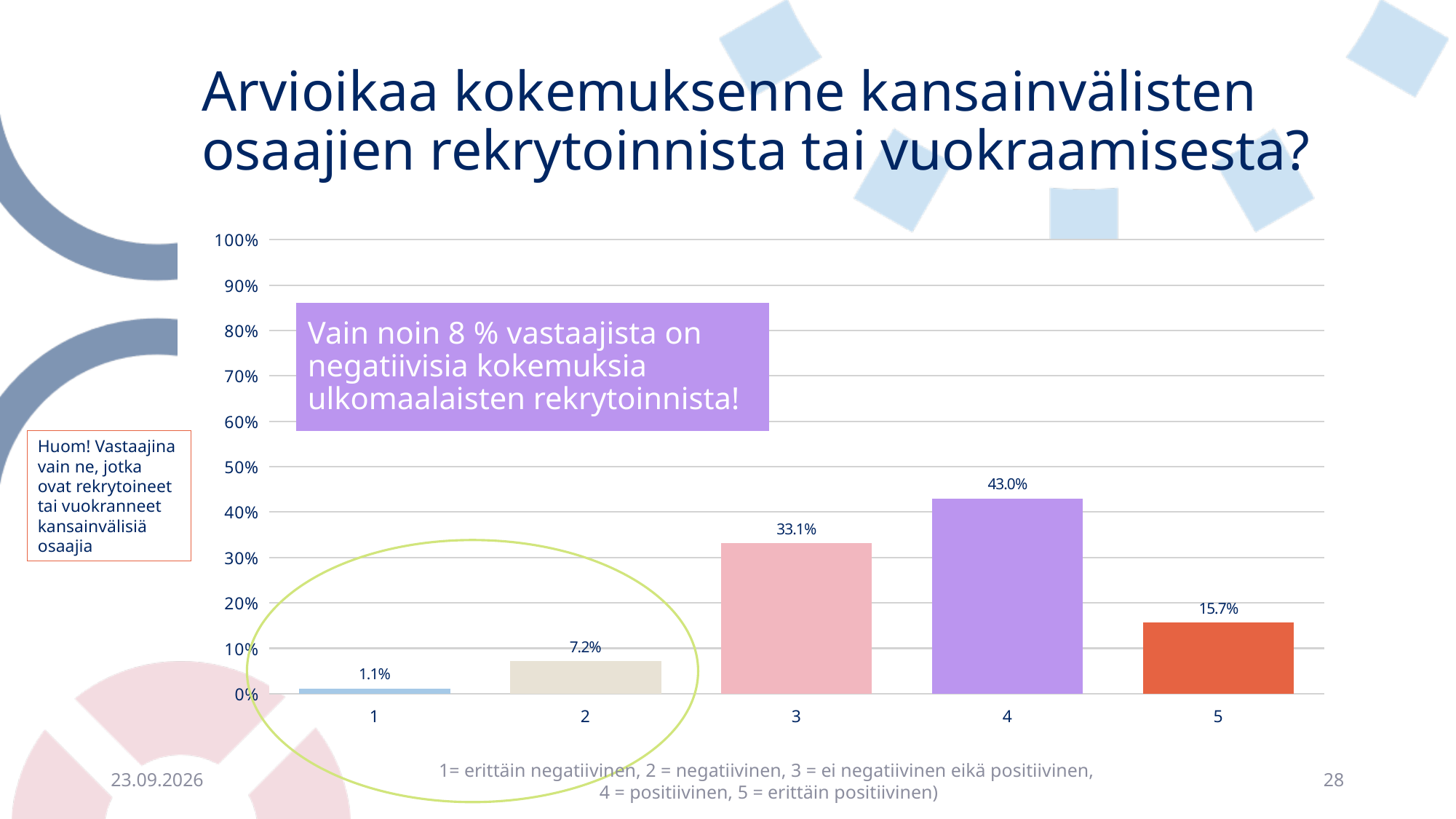
What is the value for category 1? 1.1% What is the difference between the values for category 2 and category 1? 6.1% What is the difference between the values for category 4 and category 3? 9.9% What kind of chart is shown on the slide? bar chart Which category has the highest value? 4 Which category has the lowest value? 1 What is the combined value of categories 1 and 2? 8.3% How many categories are shown on the x axis? 5 What is the value for category 4? 43.0% Which is larger, the value for category 3 or the value for category 5? 3 Is the value for category 3 greater or less than 30%? greater What is the value for category 5? 15.7%